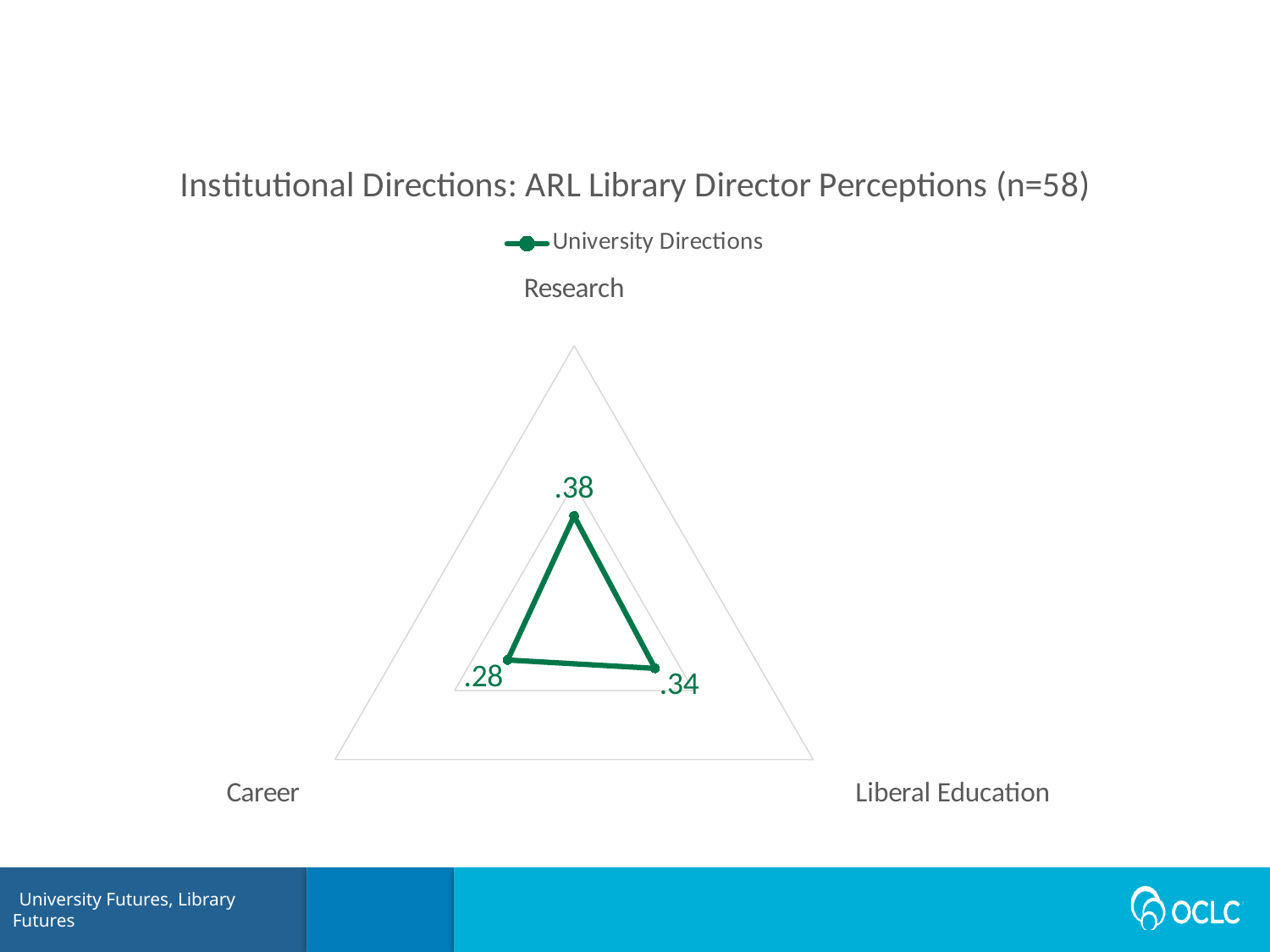
How many series does the legend list? 1 What is the value for Research? .38 Which category has the lowest value? Career What is the difference between the values for Research and Career? .10 What kind of chart is shown on the slide? Radar chart What is the value for Liberal Education? .34 Which category has the highest value? Research Which is larger, the value for Liberal Education or the value for Career? Liberal Education How many categories are plotted on the chart? 3 What is the difference between the values for Liberal Education and Career? .06 What is the value for Career? .28 What is the title of the chart? Institutional Directions: ARL Library Director Perceptions (n=58)